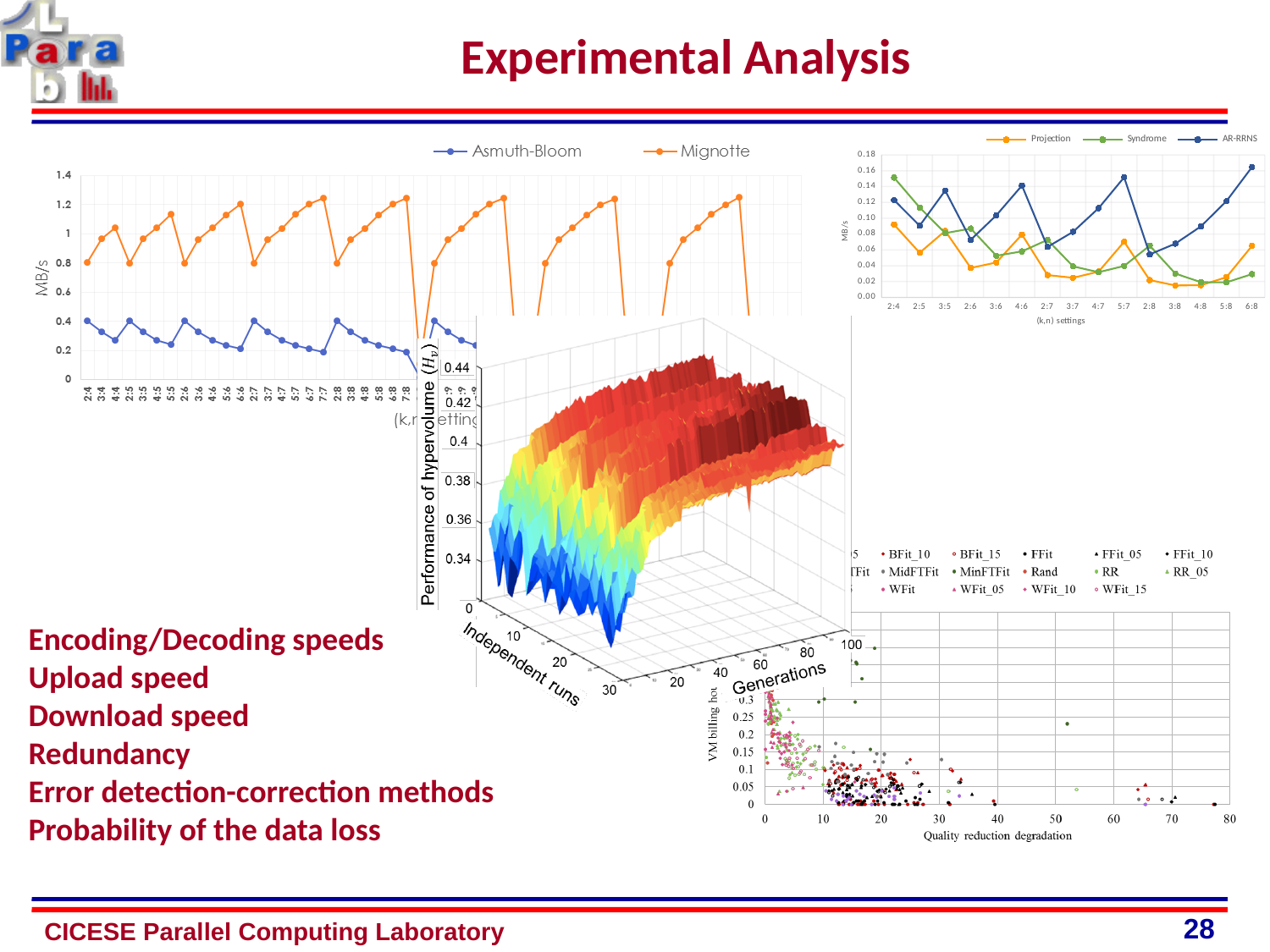
In the top-right chart, which series has the highest value at the 6:8 setting? AR-RRNS In the top-left chart, is the Asmuth-Bloom value at the 2:4 setting greater or less than 0.6? less What is the label of the vertical axis of the 3D surface chart in the centre of the slide? Performance of hypervolume (Hv) In the top-right chart, which series has the highest value at the 2:4 setting? Syndrome In the top-left chart, which series has the higher values, Asmuth-Bloom or Mignotte? Mignotte In the top-left chart, is the Mignotte value at the 2:4 setting greater or less than 0.6? greater In the top-right chart, how many series does the legend list? 3 In the top-right chart, how many (k,n) settings are shown on the x axis? 15 What kind of chart is the top-left chart comparing Asmuth-Bloom and Mignotte? line chart In the top-left chart, how many series does the legend list? 2 In the top-right chart, is the AR-RRNS value at the 6:8 setting greater or less than 0.14? greater